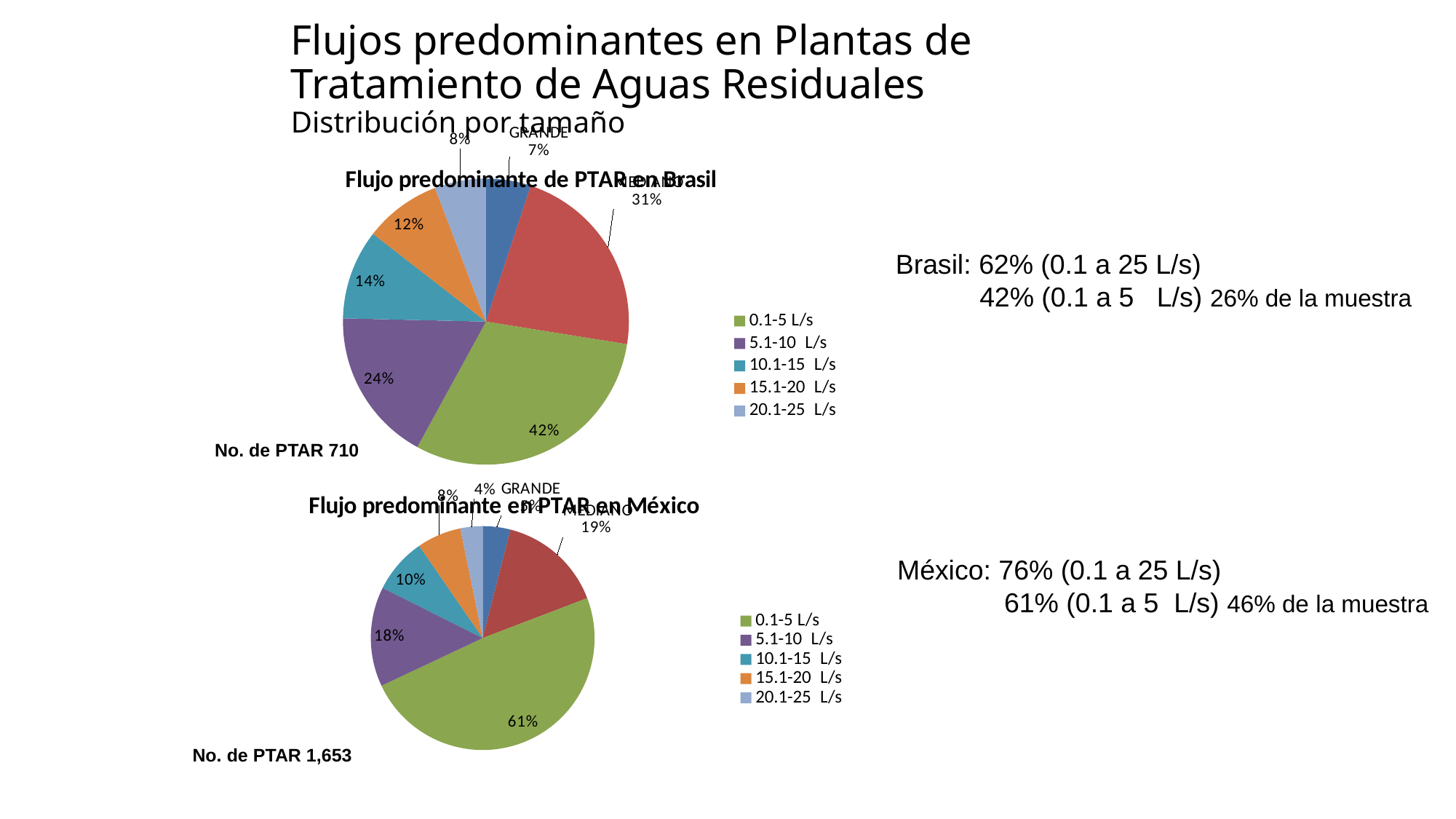
In the 'Flujo predominante de PTAR en Brasil' pie chart, what share is labelled for the MEDIANO slice? 31% In the 'Flujo predominante en PTAR en México' pie chart, which is larger, the 10.1-15 L/s slice or the 20.1-25 L/s slice? 10.1-15 L/s In the 'Flujo predominante de PTAR en Brasil' pie chart, which slice is the largest? 0.1-5 L/s In the 'Flujo predominante de PTAR en Brasil' pie chart, what share is labelled for the 0.1-5 L/s slice? 42% In the 'Flujo predominante en PTAR en México' pie chart, what share is labelled for the 5.1-10 L/s slice? 18% How many entries does the legend of the 'Flujo predominante en PTAR en México' chart list? 5 In the 'Flujo predominante en PTAR en México' pie chart, what share is labelled for the 0.1-5 L/s slice? 61% What number of PTAR is stated below the 'Flujo predominante en PTAR en México' chart? 1,653 In the 'Flujo predominante en PTAR en México' pie chart, what share is labelled for the MEDIANO slice? 19% What kind of chart is 'Flujo predominante de PTAR en Brasil'? Pie chart In the 'Flujo predominante de PTAR en Brasil' pie chart, what is the difference between the 10.1-15 L/s slice and the 15.1-20 L/s slice? 2% In the 'Flujo predominante de PTAR en Brasil' pie chart, what share is labelled for the 5.1-10 L/s slice? 24%